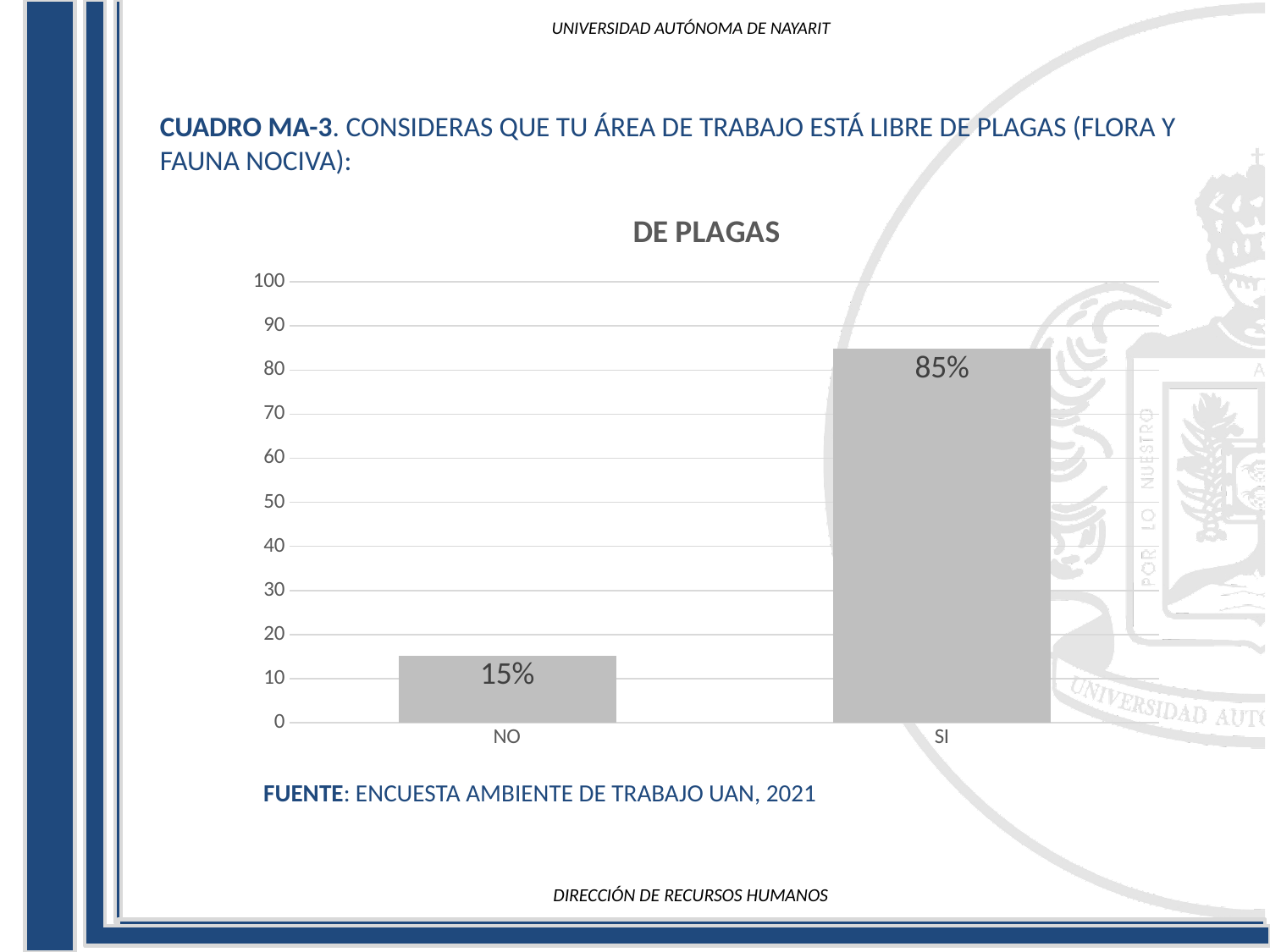
What is the value for SI? 85% Is the value for SI greater or less than 80? greater Which category has the highest value? SI What kind of chart is shown on the slide? bar chart Which is larger, the value for NO or the value for SI? SI Is the value for NO greater or less than 20? less How many categories are shown on the x axis? 2 What is the title shown above the chart? DE PLAGAS What is the difference between the values for SI and NO? 70% Which category has the lowest value? NO What is the value for NO? 15% What is the highest value shown on the y axis? 100